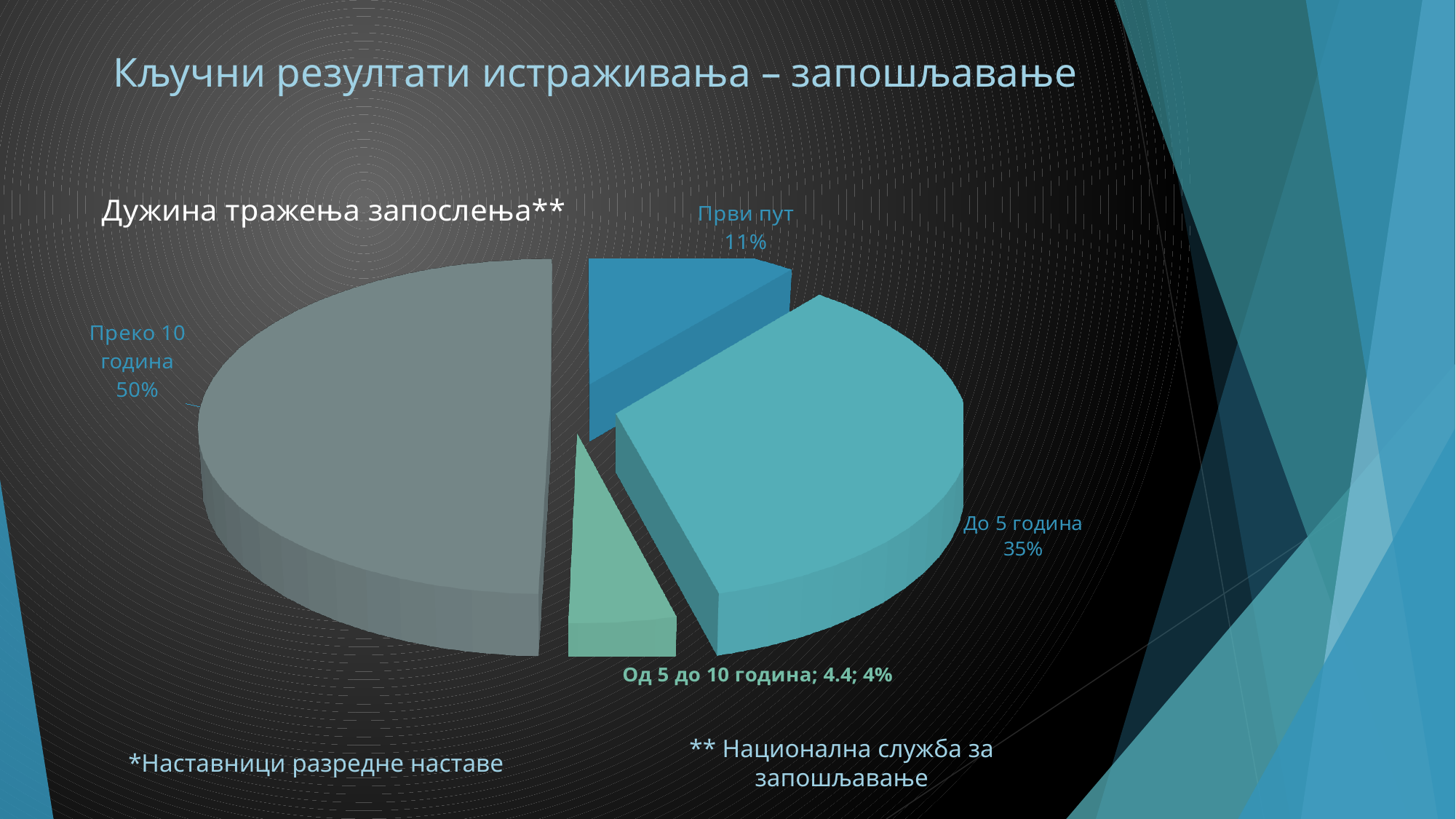
Which category has the smallest share of the pie? Од 5 до 10 година Which category has the largest share of the pie? Преко 10 година What is the difference in percentage points between "Преко 10 година" and "До 5 година"? 15 What is the title of the chart? Дужина тражења запослења** What percentage is shown for "Од 5 до 10 година"? 4% What percentage is shown for "Преко 10 година"? 50% What percentage is shown for "До 5 година"? 35% What value is printed next to "Од 5 до 10 година" before its percentage? 4.4 What percentage is shown for "Први пут"? 11% How many slices does the pie chart have? 4 Which is larger, the share for "Први пут" or the share for "До 5 година"? До 5 година What kind of chart is shown on the slide? pie chart